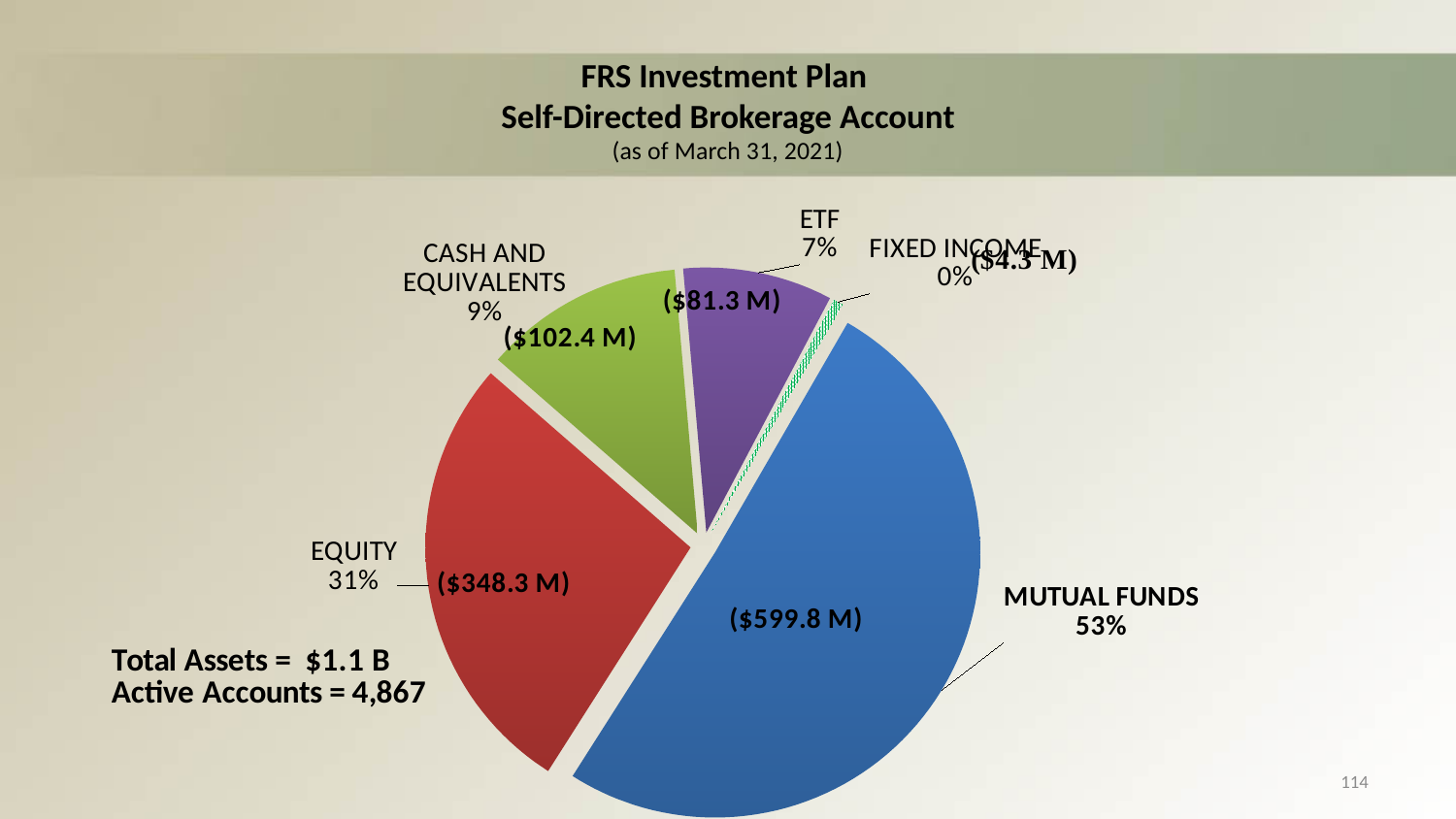
What is the difference in percentage points between the Mutual Funds share and the Equity share? 22 percentage points What is the date given in the chart title? March 31, 2021 What share of the pie does Mutual Funds represent? 53% How many categories are shown in the pie chart? 5 Which category has the smallest slice of the pie? Fixed Income What type of chart is shown on the slide? pie chart What is the dollar value shown for ETF? $81.3 M Which category has the largest slice of the pie? Mutual Funds What is the dollar value shown for Cash and Equivalents? $102.4 M What share of the pie does Equity represent? 31% What is the dollar value shown for Fixed Income? $4.3 M Which is larger, the value for Equity or the value for Cash and Equivalents? Equity